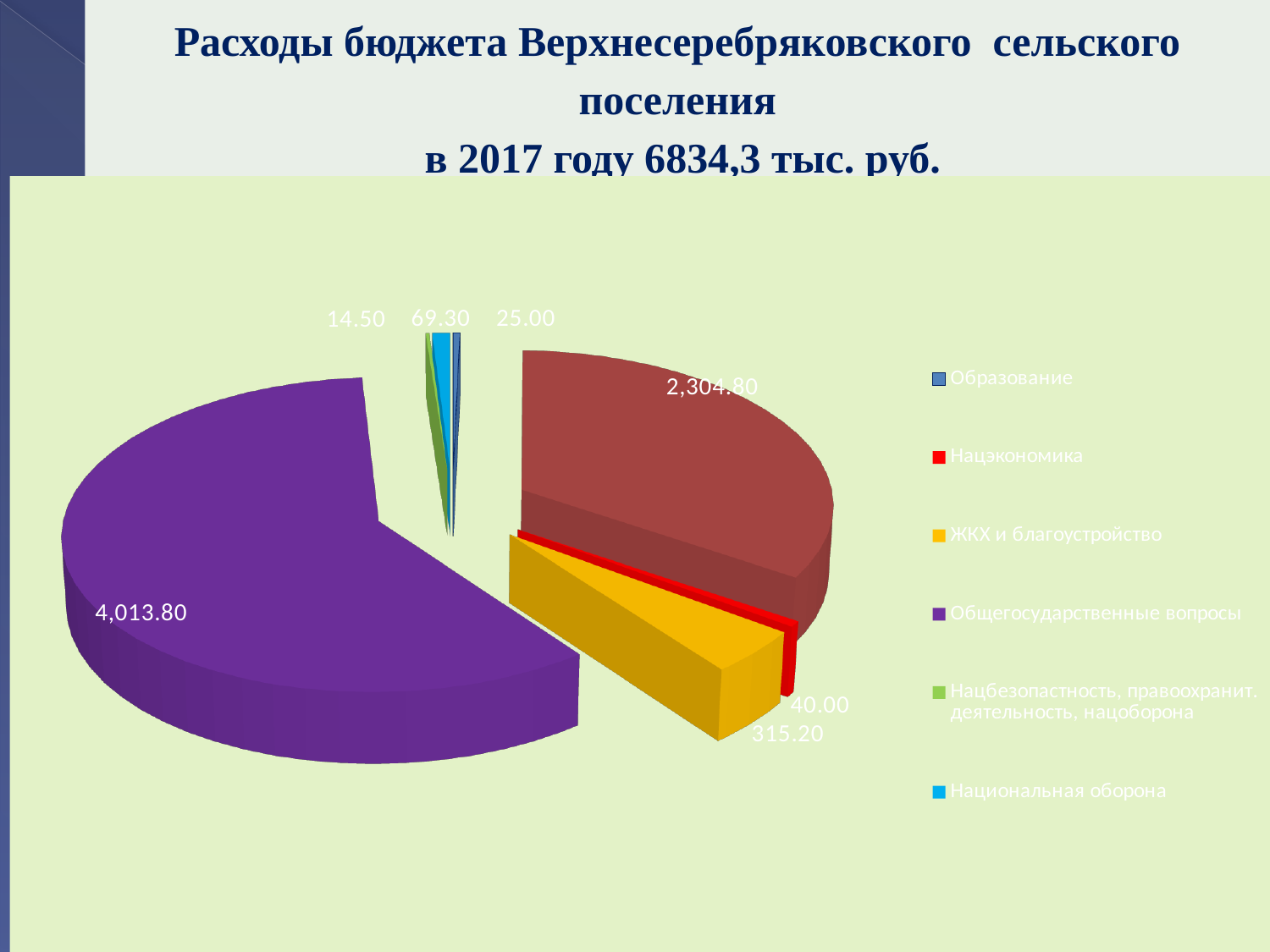
Which category has the smallest slice of the pie? Нацбезопастность, правоохранит. деятельность, нацоборона What is the value for Образование? 25.00 What is the difference between the values for Общегосударственные вопросы and ЖКХ и благоустройство? 3,698.60 What is the value for ЖКХ и благоустройство? 315.20 How many entries does the legend list? 6 What is the value for Нацэкономика? 40.00 What is the value for Национальная оборона? 69.30 What type of chart is shown on the slide? pie chart Which category has the largest slice of the pie? Общегосударственные вопросы What is the value for Общегосударственные вопросы? 4,013.80 What is the difference between the values for ЖКХ и благоустройство and Нацэкономика? 275.20 Which is larger, the value for Национальная оборона or the value for Образование? Национальная оборона